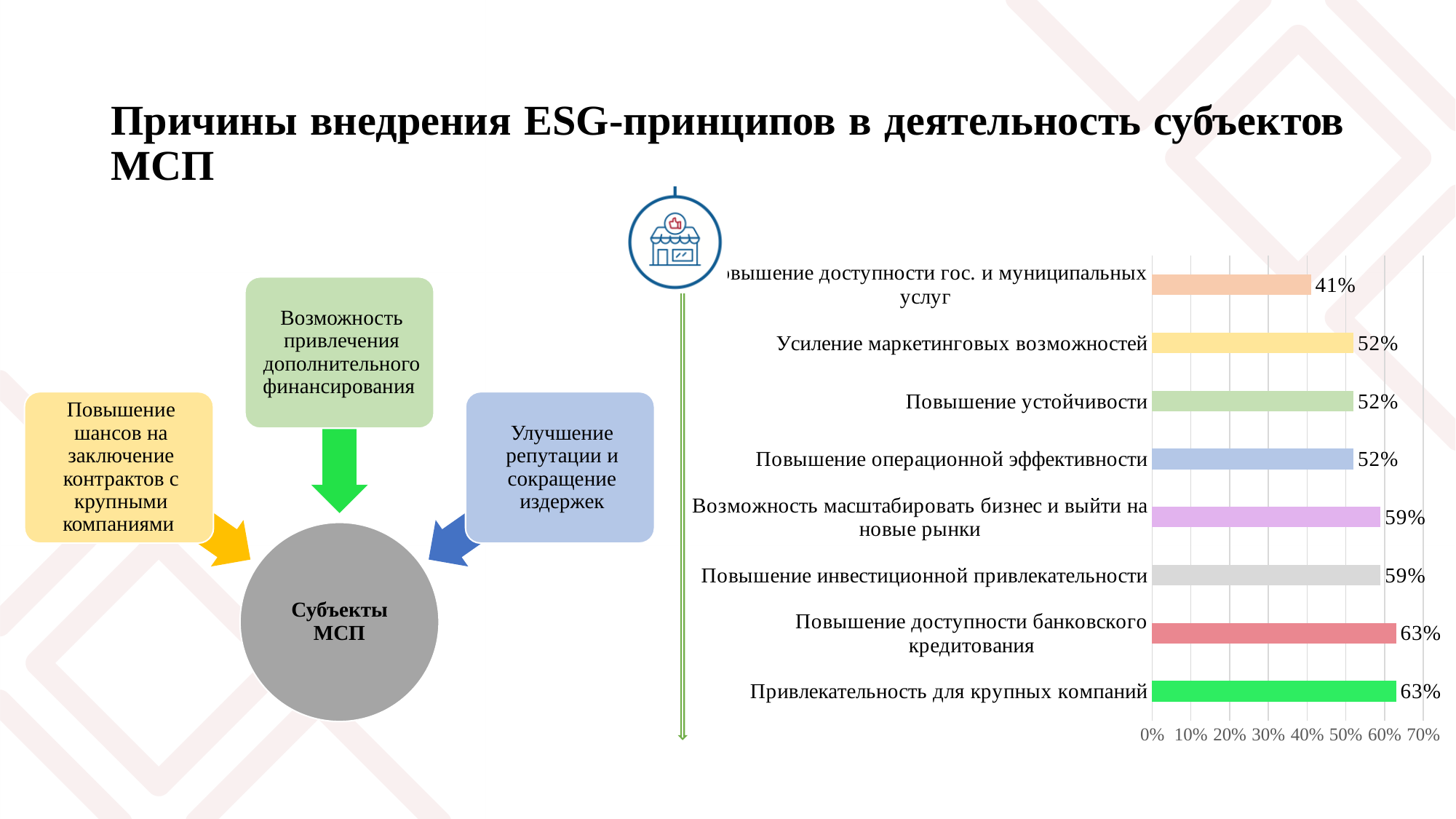
What is the value for "Повышение доступности банковского кредитования"? 63% Which is larger: the value for "Возможность масштабировать бизнес и выйти на новые рынки" or the value for "Повышение операционной эффективности"? Возможность масштабировать бизнес и выйти на новые рынки How many categories does the bar chart show? 8 What is the value for "Привлекательность для крупных компаний"? 63% What is the value for "Усиление маркетинговых возможностей"? 52% What is the difference between the value for "Привлекательность для крупных компаний" and the value for "Повышение доступности гос. и муниципальных услуг"? 22 percentage points What is the value for "Повышение инвестиционной привлекательности"? 59% Which category has the lowest value in the chart? Повышение доступности гос. и муниципальных услуг What is the value for "Повышение устойчивости"? 52% What kind of chart is shown on the slide? bar chart What is the highest tick value shown on the horizontal axis of the chart? 70% Is the value for "Повышение доступности гос. и муниципальных услуг" greater or less than 50%? less